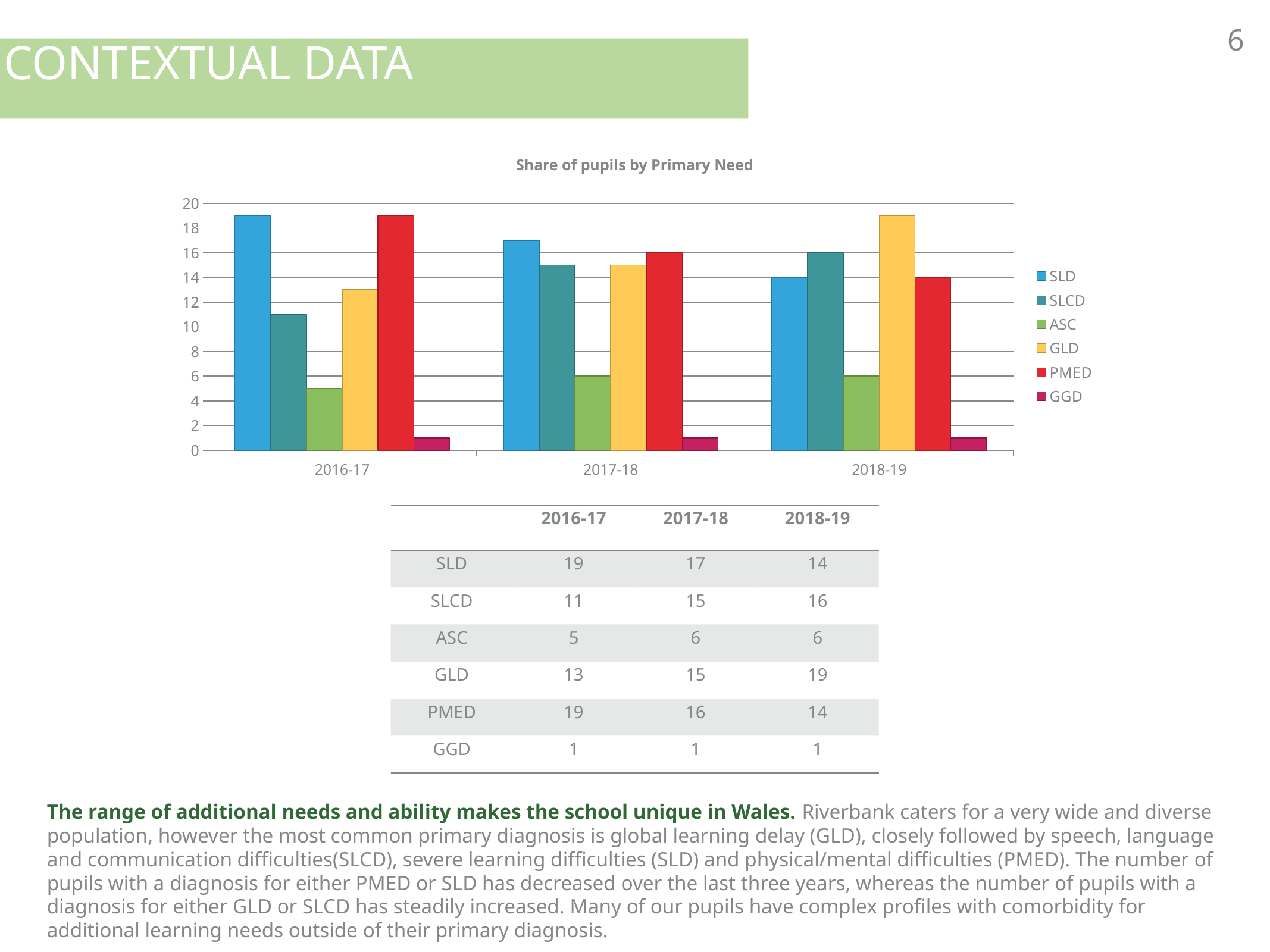
What is the value for GLD in 2018-19? 19 Which series has the highest value in 2018-19? GLD Do the SLD values rise or fall from 2016-17 to 2018-19? Fall How many year categories are shown on the x axis? 3 Which is larger in 2017-18, SLD or PMED? SLD What is the difference between the SLD values for 2016-17 and 2018-19? 5 What is the value for SLCD in 2017-18? 15 How many series does the chart legend list? 6 What is the value for SLD in 2016-17? 19 What is the title of the chart? Share of pupils by Primary Need What kind of chart is shown on the slide? Bar chart Which series has the lowest value in 2018-19? GGD